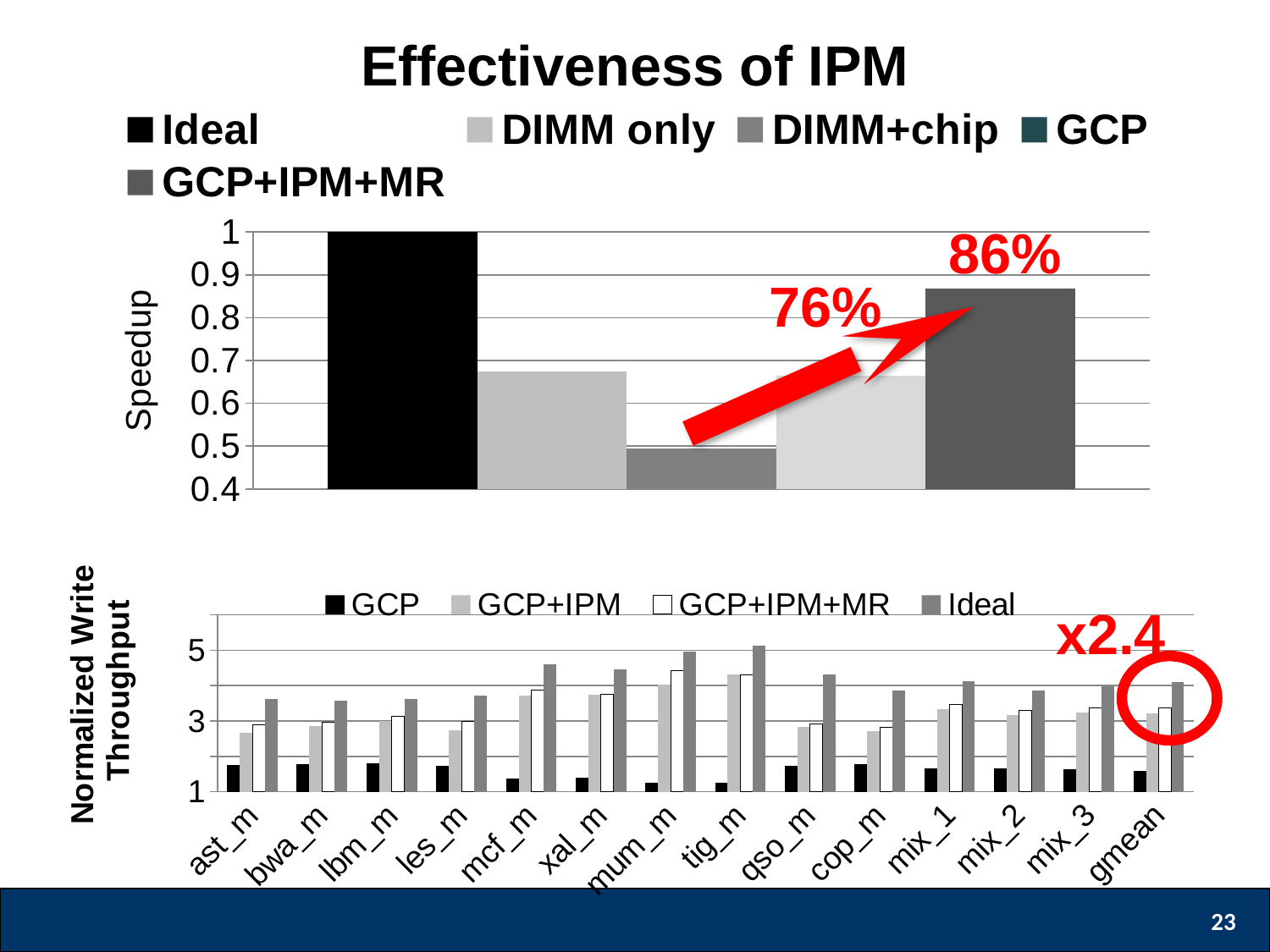
In the top chart, is the Speedup for GCP+IPM+MR greater or less than 0.8? greater In the bottom chart (Normalized Write Throughput), is the Ideal value for ast_m greater or less than 3? greater In the top chart, is the Speedup for DIMM+chip greater or less than 0.6? less What kind of chart is the top chart on the slide? bar chart How many series does the legend of the top chart list? 5 How many series does the legend of the bottom chart (Normalized Write Throughput) list? 4 In the top chart, what is the Speedup value for Ideal? 1 What is the y-axis label of the top chart? Speedup In the top chart, which series has the lowest Speedup? DIMM+chip In the top chart, which is larger, the Speedup for DIMM only or for DIMM+chip? DIMM only How many categories are shown on the x axis of the bottom chart (Normalized Write Throughput)? 14 In the bottom chart (Normalized Write Throughput), which series has the highest value for tig_m? Ideal